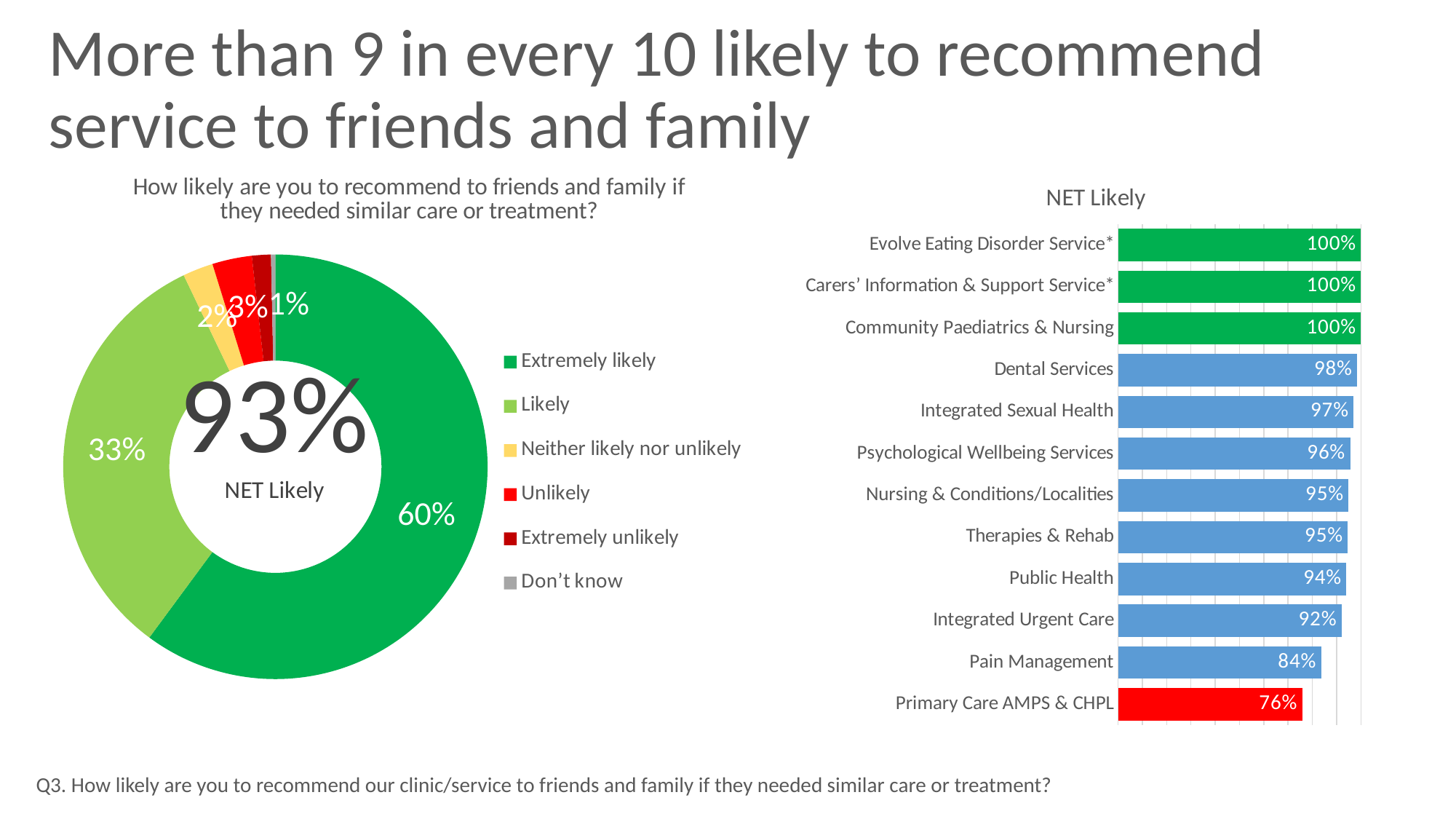
In the donut chart on the left, what share of respondents answered Extremely likely? 60% In the NET Likely bar chart, which is larger: Public Health or Pain Management? Public Health What is the NET Likely figure shown in the centre of the donut chart? 93% In the NET Likely bar chart, how many services have a value of 100%? 3 What kind of chart is the NET Likely chart on the right? Bar chart How many entries does the legend of the donut chart list? 6 In the donut chart on the left, what share of respondents answered Likely? 33% In the NET Likely bar chart, what is the value for Pain Management? 84% How many services are shown in the NET Likely bar chart? 12 In the NET Likely bar chart, which service has the lowest value? Primary Care AMPS & CHPL In the NET Likely bar chart, what is the difference between Integrated Sexual Health and Integrated Urgent Care? 5% In the NET Likely bar chart, what is the value for Dental Services? 98%